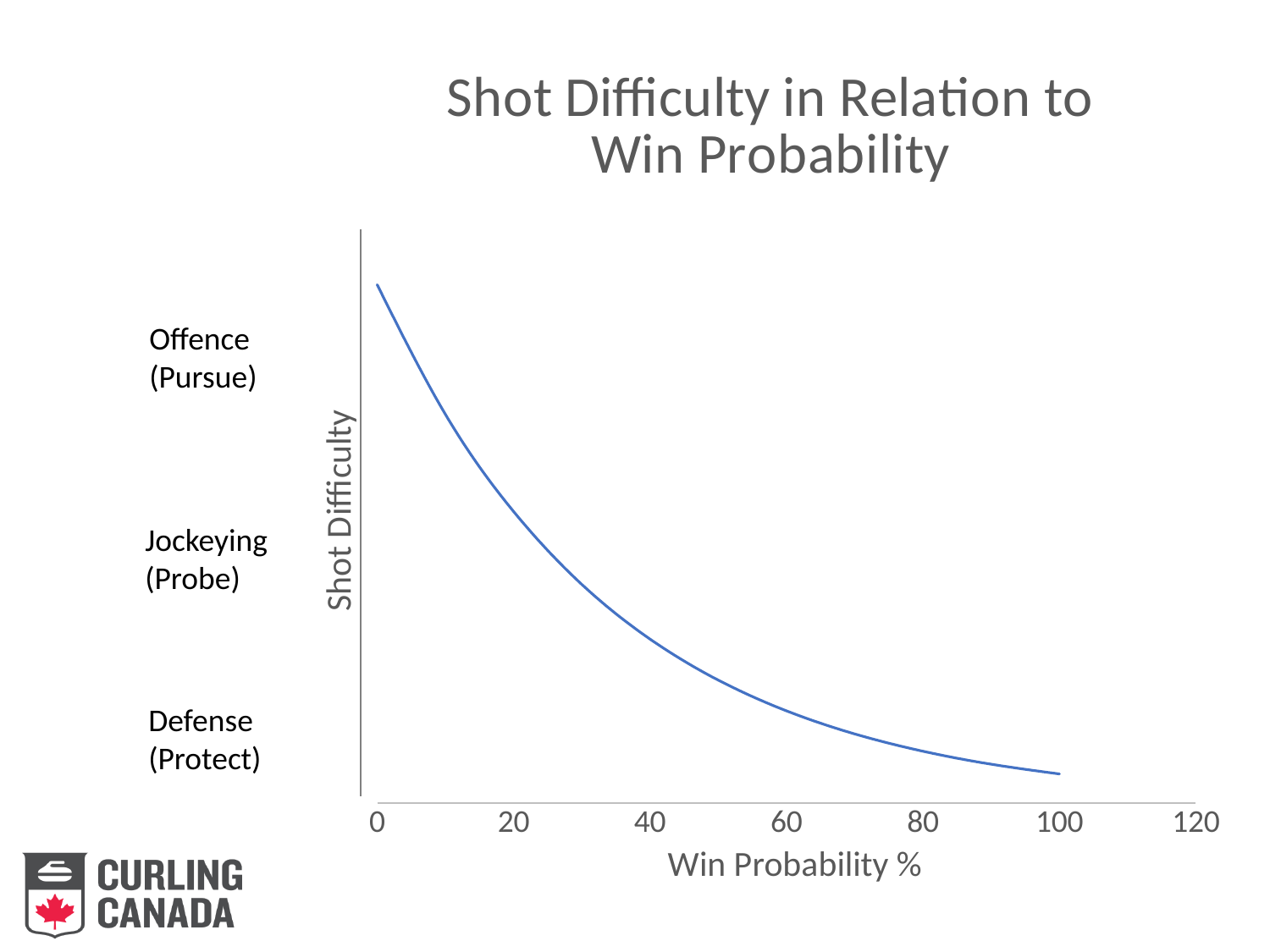
What is the label of the x axis? Win Probability % What is the title of the chart? Shot Difficulty in Relation to Win Probability At which x-axis value does the plotted curve end? 100 Which is larger: the Shot Difficulty at a Win Probability of 0 or at a Win Probability of 100? At 0 As Win Probability % increases along the x axis, does Shot Difficulty rise or fall? Fall What kind of chart is shown on the slide? Line chart How many lines are plotted on the chart? 1 Which is larger: the Shot Difficulty at a Win Probability of 20 or at a Win Probability of 80? At 20 At which end of the x axis does the curve reach its highest Shot Difficulty? 0 What is the highest tick value shown on the x axis? 120